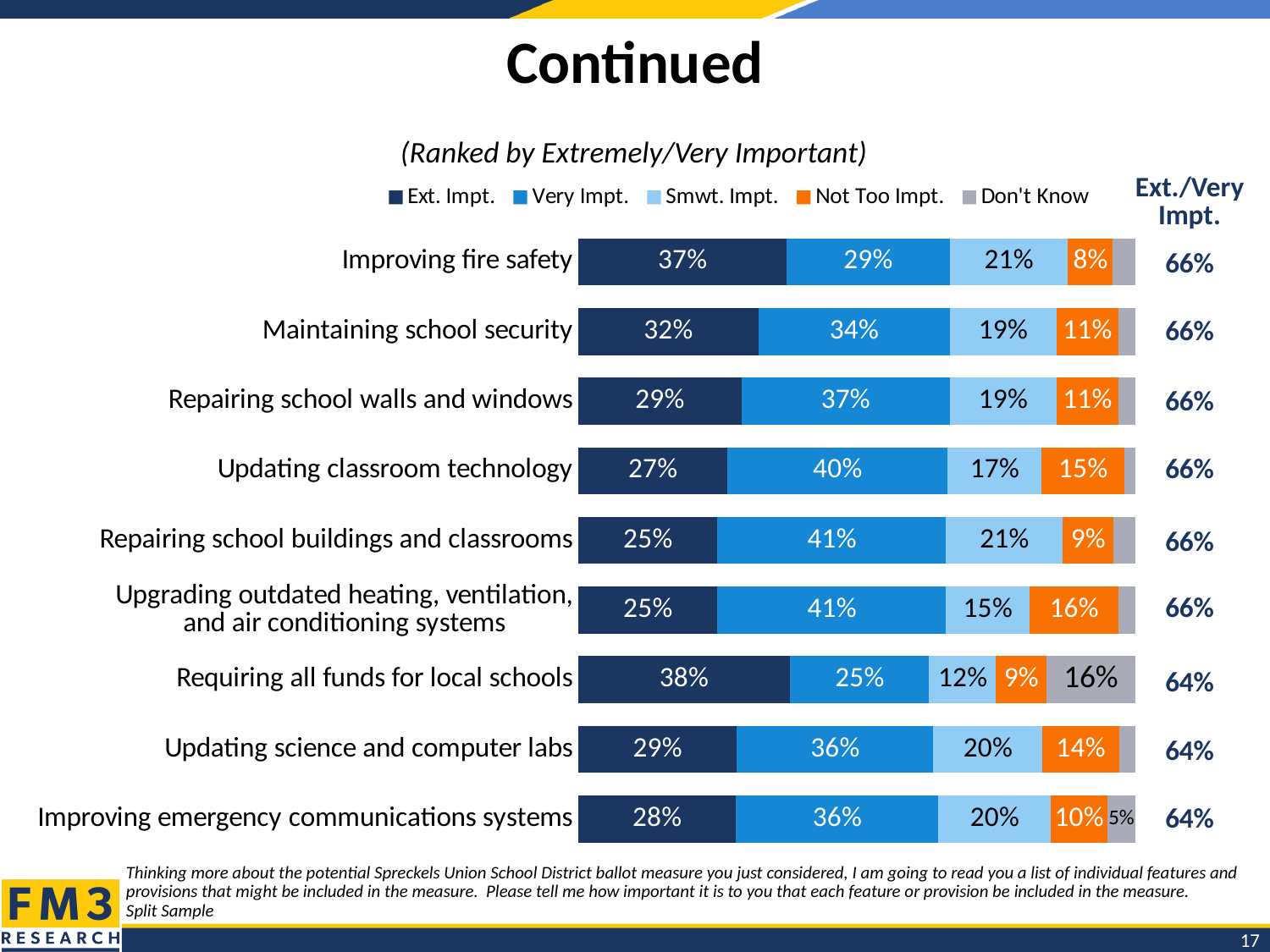
Which category has the lowest Not Too Impt. value? Improving fire safety Which has a larger Smwt. Impt. value: "Improving fire safety" or "Upgrading outdated heating, ventilation, and air conditioning systems"? Improving fire safety What is the Not Too Impt. value for "Upgrading outdated heating, ventilation, and air conditioning systems"? 16% What type of chart is shown on the slide? Stacked bar chart What is the Don't Know value for "Requiring all funds for local schools"? 16% Which category has the highest Ext. Impt. value? Requiring all funds for local schools How many series does the legend list? 5 What is the Ext./Very Impt. combined value shown for "Updating science and computer labs"? 64% For "Repairing school buildings and classrooms", how much larger is the Very Impt. value than the Ext. Impt. value? 16 percentage points How many categories (features) are shown in the chart? 9 What is the Very Impt. value for "Updating classroom technology"? 40% What percentage rated "Improving fire safety" as Ext. Impt.? 37%